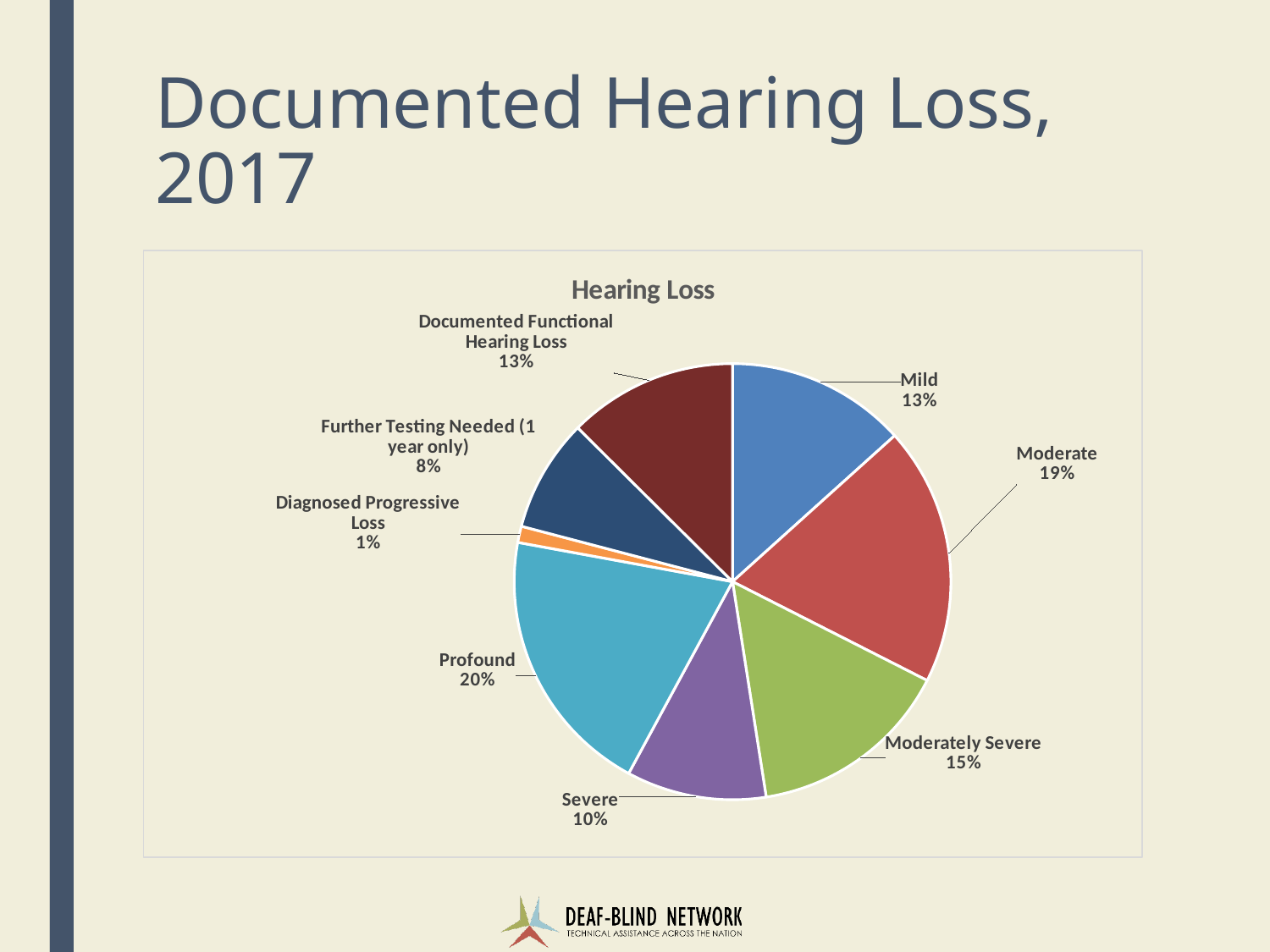
Which category has the smallest slice of the pie? Diagnosed Progressive Loss What is the difference in percentage points between Profound and Severe? 10 Which is larger, Moderate or Moderately Severe? Moderate How many slices does the pie chart have? 8 What share of the pie is Further Testing Needed (1 year only)? 8% What share of the pie is Moderately Severe? 15% What share of the pie is Profound? 20% What is the title of the chart? Hearing Loss What kind of chart is shown on the slide? pie chart Which category has the largest slice of the pie? Profound